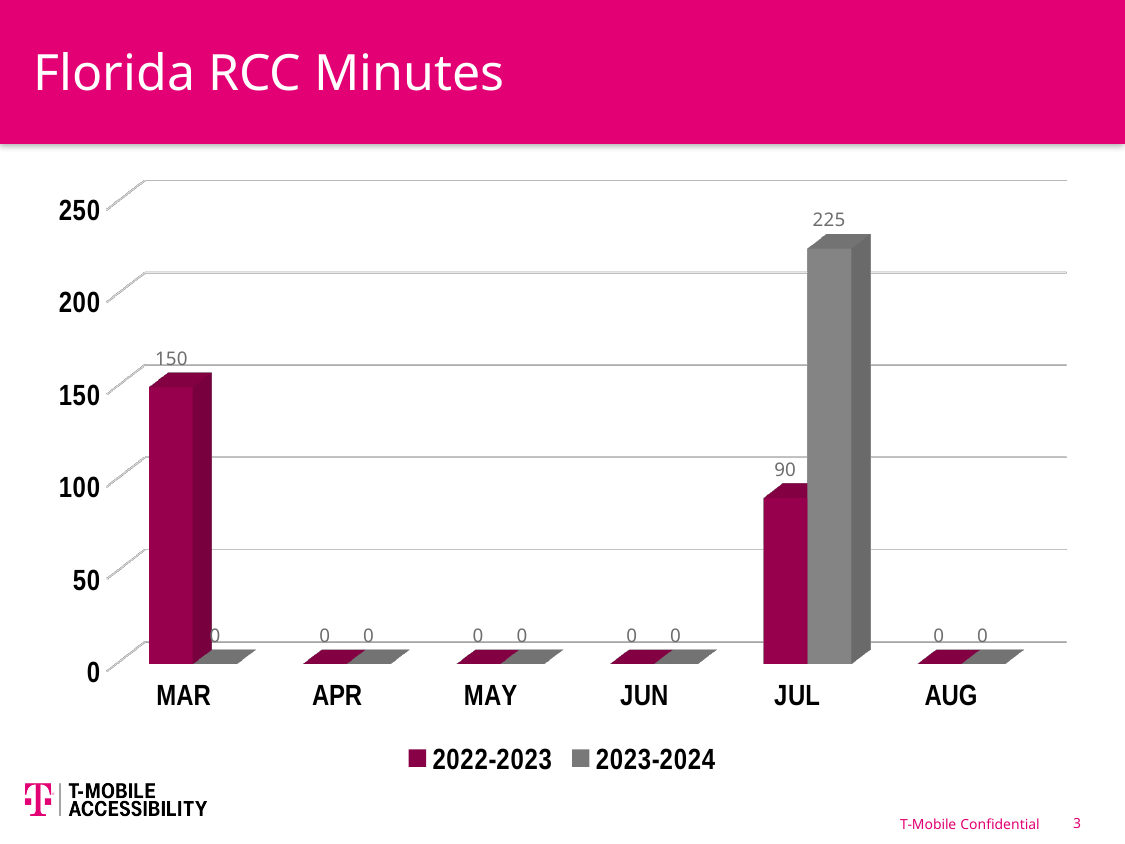
What is the value for MAR in the 2023-2024 series? 0 Which month has the highest value in the 2022-2023 series? MAR What kind of chart is shown on the slide? Bar chart What is the difference between the 2022-2023 values for MAR and JUL? 60 How many months are shown on the x axis? 6 How many series does the legend list? 2 What is the difference between the 2023-2024 and 2022-2023 values for JUL? 135 What is the value for JUL in the 2023-2024 series? 225 Which month has the highest value in the 2023-2024 series? JUL Which is larger: the 2022-2023 value for MAR or the 2023-2024 value for JUL? 2023-2024 value for JUL What is the value for JUL in the 2022-2023 series? 90 What is the value for MAR in the 2022-2023 series? 150